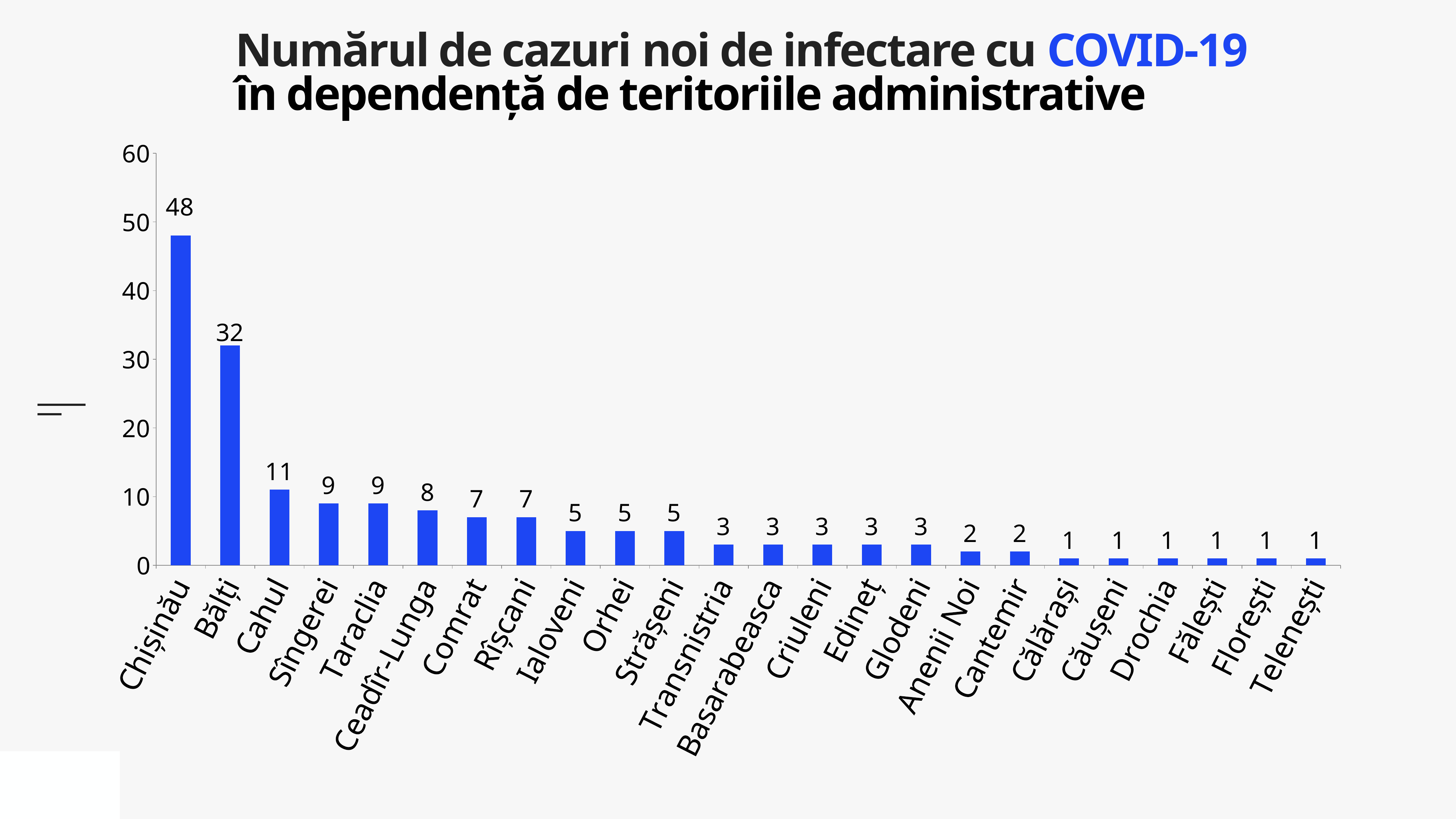
What kind of chart is shown on the slide? bar chart What is the difference between the values for Chișinău and Bălți? 16 What is the value for Orhei? 5 What is the value for Cahul? 11 Is the value for Bălți greater or less than 40? less Which territory has the highest number of new cases? Chișinău What is the value for Ceadîr-Lunga? 8 What is the value for Chișinău? 48 What is the difference between the values for Cahul and Comrat? 4 Which is larger, the value for Taraclia or the value for Rîșcani? Taraclia How many territories are shown on the x axis? 24 What is the value for Bălți? 32